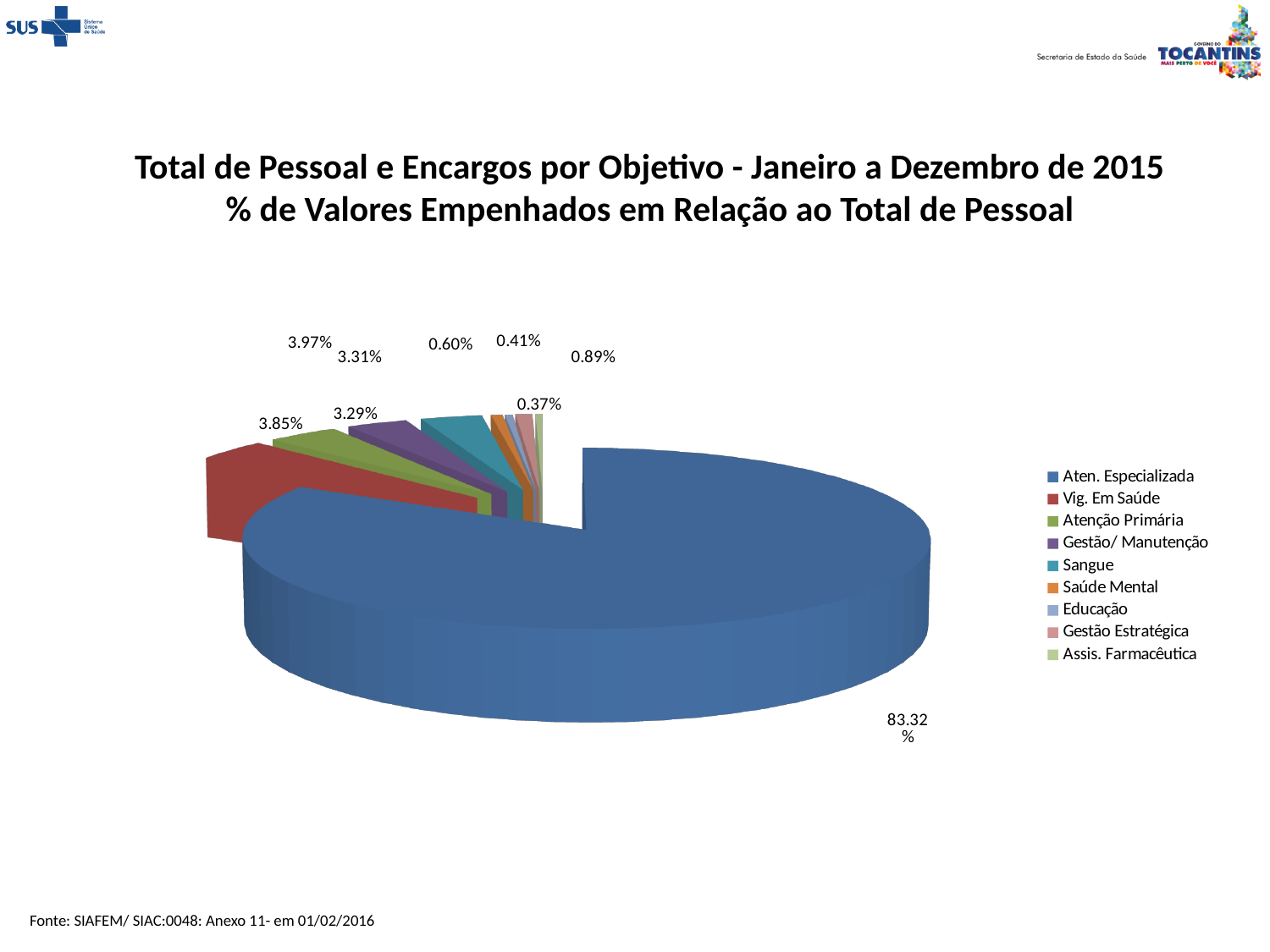
What kind of chart is shown on the slide? pie chart What is the first line of the chart's title? Total de Pessoal e Encargos por Objetivo - Janeiro a Dezembro de 2015 What percentage is shown for Aten. Especializada? 83.32% Which category has the largest share of the pie? Aten. Especializada How many categories does the pie chart's legend list? 9 What percentage is shown for Vig. Em Saúde? 3.97% Is the share for Aten. Especializada greater or less than 50%? greater What is the smallest percentage label shown on the pie chart? 0.37% What is the largest percentage label shown on the pie chart? 83.32% Which category is listed last in the legend? Assis. Farmacêutica Which is larger, the share for Aten. Especializada or the share for Vig. Em Saúde? Aten. Especializada